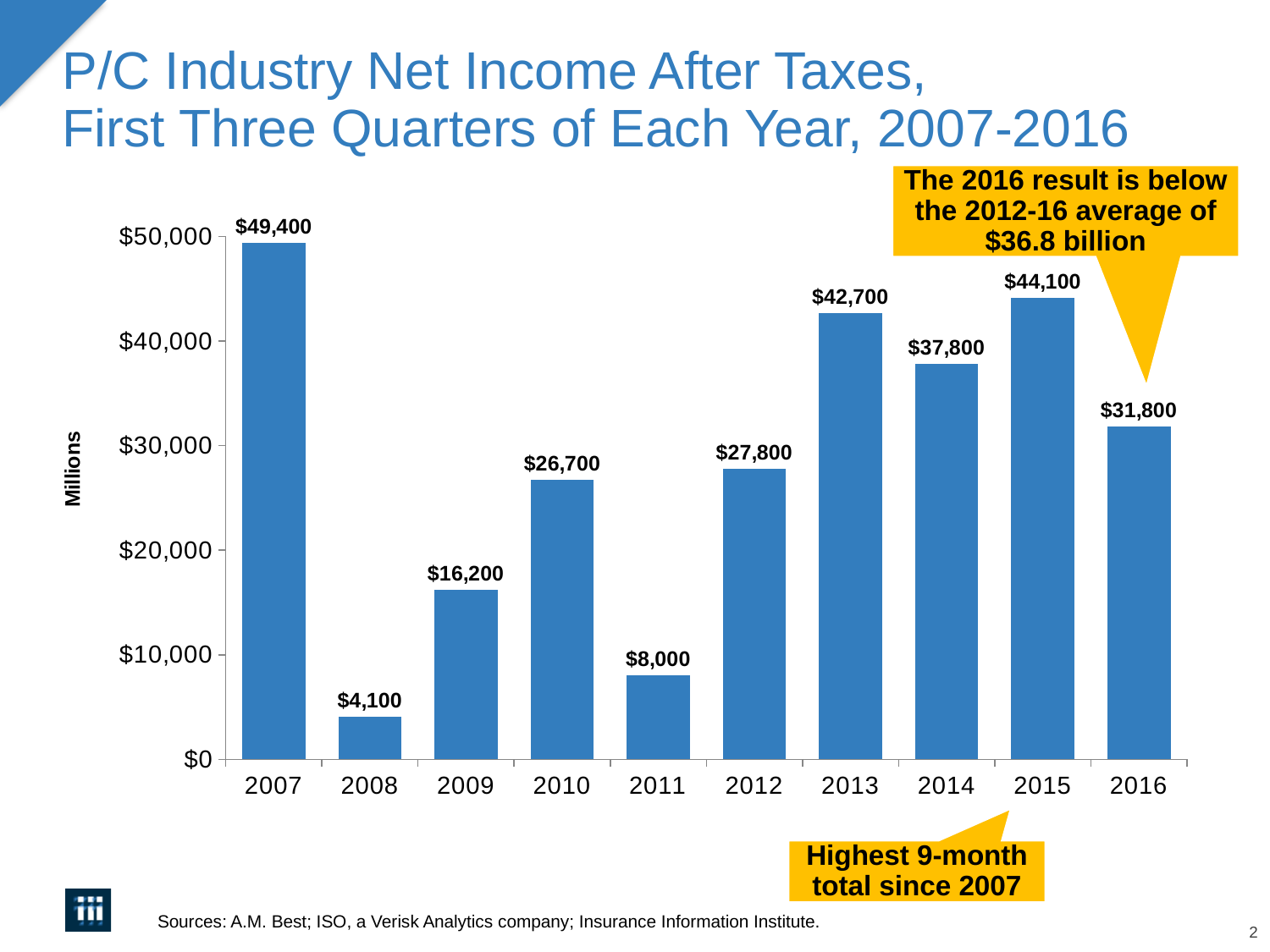
How many years are shown on the x axis? 10 What kind of chart is shown on the slide? bar chart What is the value shown for 2011? $8,000 What is the net income after taxes for 2007? $49,400 Is the value for 2010 greater or less than $30,000? less What is the difference between the 2007 and 2008 values? $45,300 What is the value shown for 2016? $31,800 Which year has the lowest value? 2008 What unit is given on the y axis label? Millions Which year has the highest value? 2007 Which is larger, the value for 2013 or the value for 2014? 2013 What is the difference between the 2015 and 2016 values? $12,300